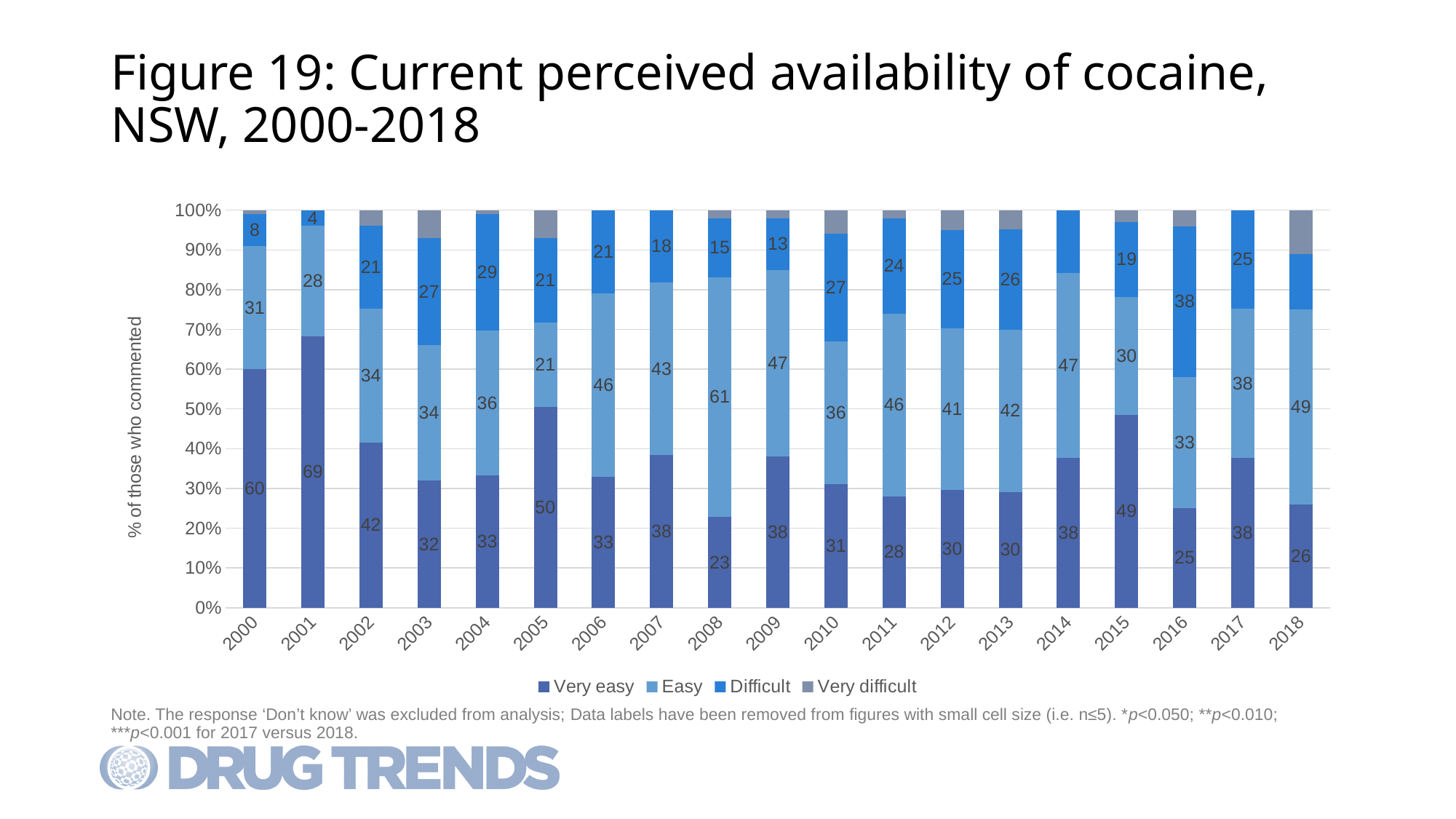
What is the value for 'Easy' in 2008? 61 Does the 'Very easy' value rise or fall from 2015 to 2016? Fall What is the difference between the 'Very easy' values for 2017 and 2018? 12 In which year is the 'Very easy' value highest? 2001 What is the value for 'Difficult' in 2016? 38 What is the value for 'Very easy' in 2000? 60 Which is larger, the 'Easy' value in 2009 or the 'Easy' value in 2010? 2009 What kind of chart is shown on the slide? Stacked bar chart In which year is the 'Very easy' value lowest? 2008 How many years are shown on the x axis? 19 What is the label of the y axis? % of those who commented How many series does the legend list? 4